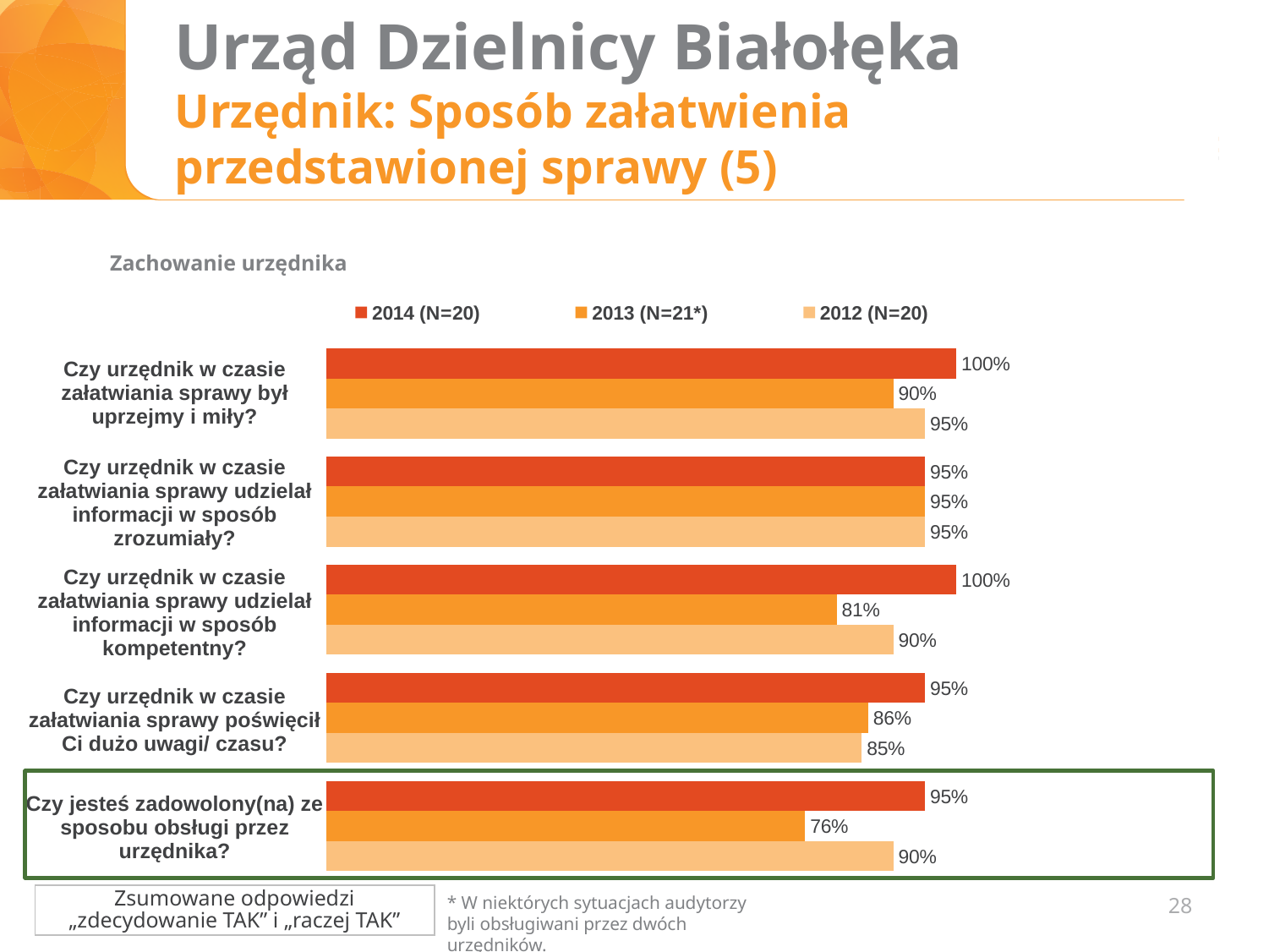
What is the 2013 (N=21*) value for "Czy jesteś zadowolony(na) ze sposobu obsługi przez urzędnika?"? 76% What is the difference between the 2014 and 2013 values for "Czy urzędnik w czasie załatwiania sprawy udzielał informacji w sposób kompetentny?"? 19 percentage points For "Czy urzędnik w czasie załatwiania sprawy był uprzejmy i miły?", which year has the larger value: 2013 or 2012? 2012 What is the difference between the 2014 and 2013 values for "Czy jesteś zadowolony(na) ze sposobu obsługi przez urzędnika?"? 19 percentage points Which question has the lowest 2013 (N=21*) value? Czy jesteś zadowolony(na) ze sposobu obsługi przez urzędnika? What is the title of the chart? Zachowanie urzędnika What is the 2013 (N=21*) value for "Czy urzędnik w czasie załatwiania sprawy poświęcił Ci dużo uwagi/ czasu?"? 86% What is the 2014 (N=20) value for "Czy urzędnik w czasie załatwiania sprawy był uprzejmy i miły?"? 100% What type of chart is shown on the slide? Bar chart How many series does the legend list? 3 What is the 2012 (N=20) value for "Czy urzędnik w czasie załatwiania sprawy udzielał informacji w sposób kompetentny?"? 90% How many questions (categories) are shown on the chart? 5